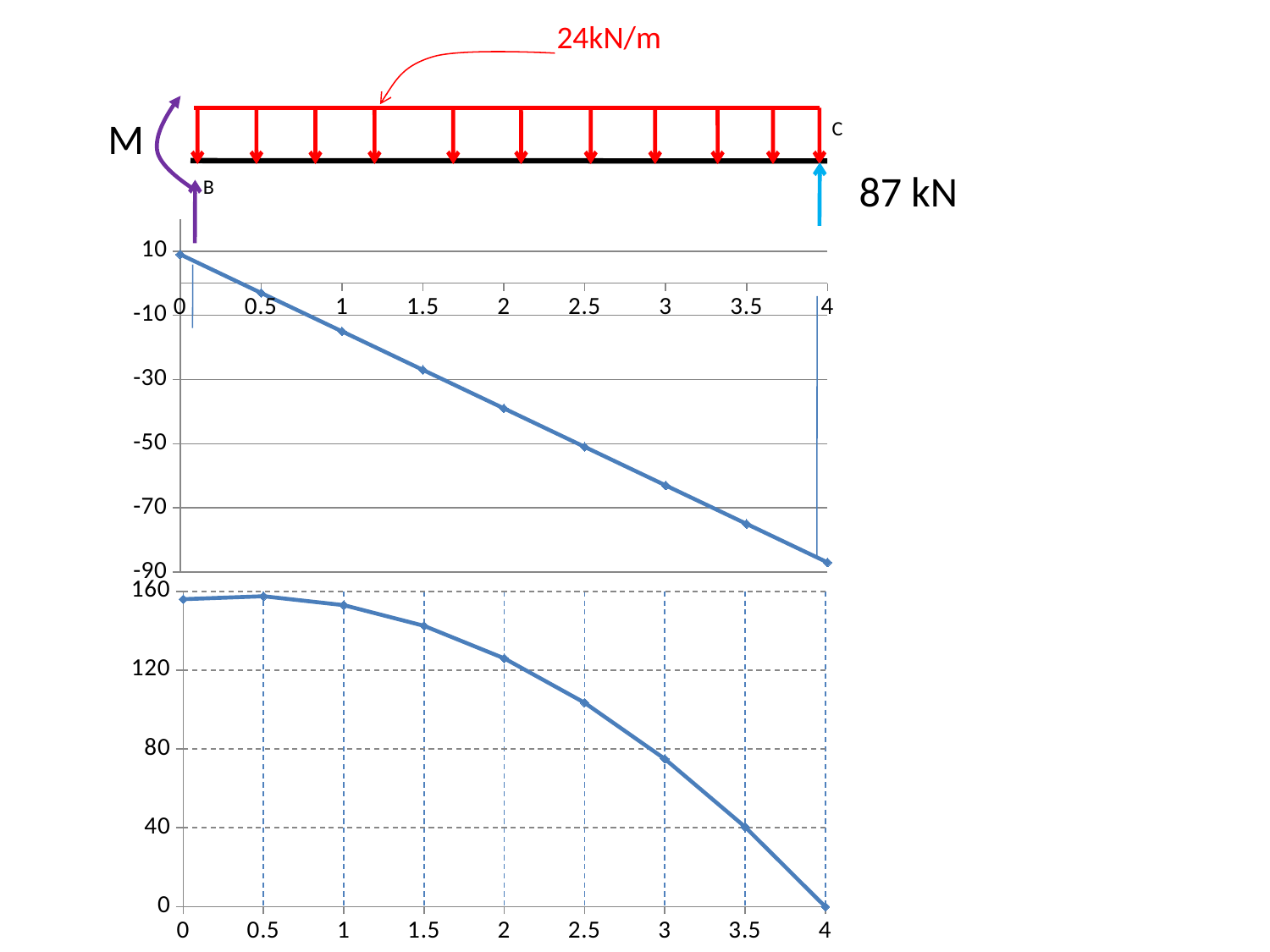
In the lower chart, is the value at x = 2 greater or less than 120? greater In the upper chart, at which x value is the plotted value highest? 0 In the lower chart, what is the value at x = 4? 0 In the lower chart, is the value at x = 3 greater or less than 80? less What kind of chart is the lower chart on the slide? line chart In the lower chart, at which x value is the plotted value lowest? 4 In the upper chart, which is larger: the value at x = 1 or the value at x = 3? x = 1 In the upper chart, at which x value is the plotted value lowest? 4 What kind of chart is the upper chart on the slide? line chart In the lower chart, how many data points are plotted? 9 In the upper chart, how many data points are plotted? 9 In the upper chart, do the values rise or fall as x increases from 0 to 4? fall